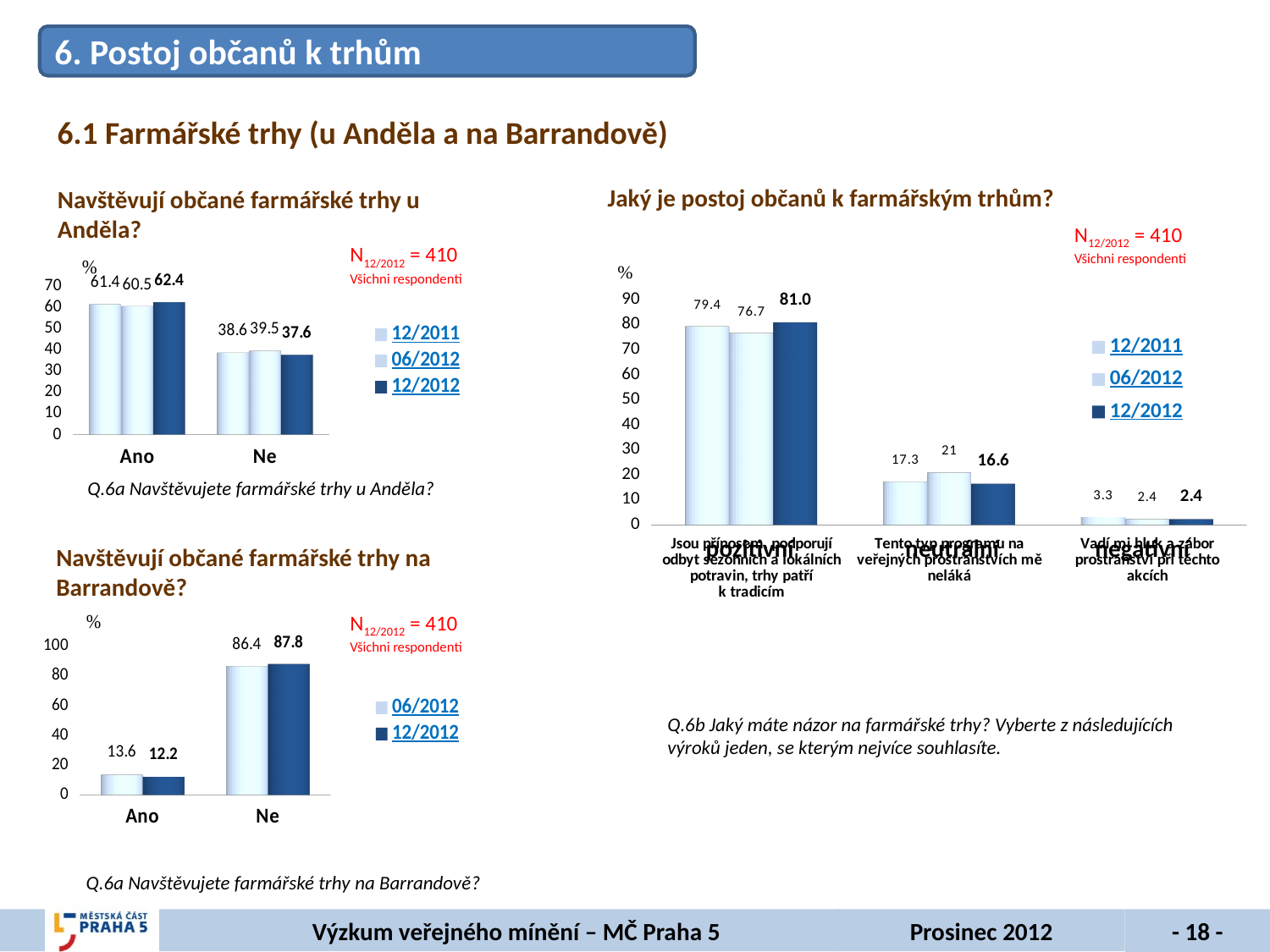
In the chart 'Jaký je postoj občanů k farmářským trhům?', what is the value for 'pozitivní' in the 12/2012 series? 81.0 In the chart 'Navštěvují občané farmářské trhy na Barrandově?', what is the value for 'Ano' in the 06/2012 series? 13.6 In the chart 'Navštěvují občané farmářské trhy u Anděla?', what is the value for 'Ne' in the 12/2011 series? 38.6 In the chart 'Navštěvují občané farmářské trhy na Barrandově?', which category has the higher value in the 12/2012 series, 'Ano' or 'Ne'? Ne In the chart 'Navštěvují občané farmářské trhy u Anděla?', how many series does the legend list? 3 In the chart 'Navštěvují občané farmářské trhy u Anděla?', what is the value for 'Ano' in the 12/2012 series? 62.4 In the chart 'Navštěvují občané farmářské trhy na Barrandově?', how many series does the legend list? 2 In the chart 'Navštěvují občané farmářské trhy u Anděla?', what is the difference between the 'Ano' and 'Ne' values in the 06/2012 series? 21.0 What kind of chart is 'Jaký je postoj občanů k farmářským trhům?'? bar chart In the chart 'Jaký je postoj občanů k farmářským trhům?', what is the value for 'neutrální' in the 06/2012 series? 21 In the chart 'Jaký je postoj občanů k farmářským trhům?', which category has the lowest value in the 12/2011 series? negativní In the chart 'Navštěvují občané farmářské trhy na Barrandově?', what is the value for 'Ne' in the 12/2012 series? 87.8